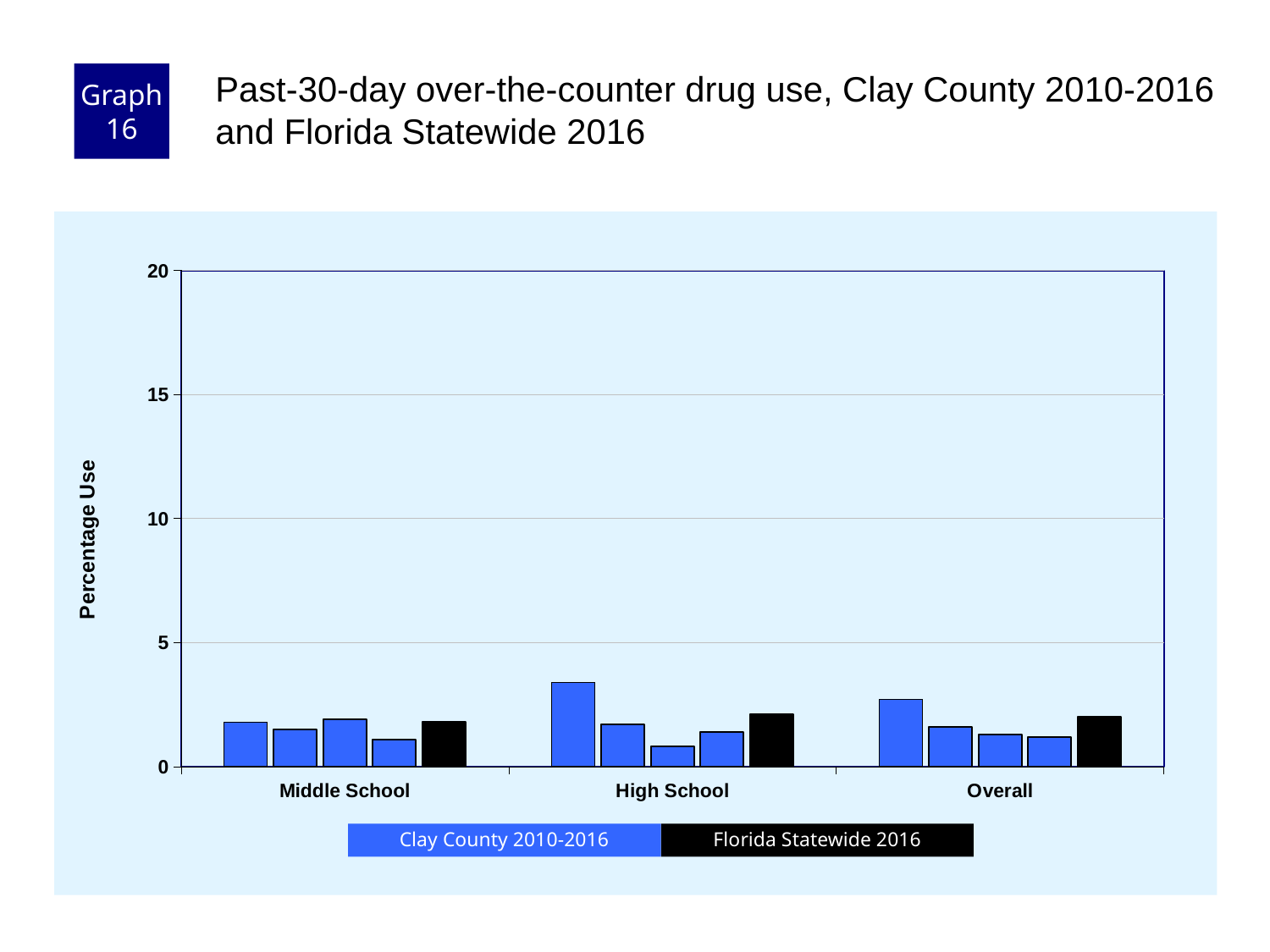
Is the value of the tallest bar in the High School group greater or less than 5? less Which is larger: the first Clay County bar in the High School group or the first Clay County bar in the Middle School group? the first Clay County bar in the High School group How many categories are shown on the x axis? 3 What colour are the Florida Statewide 2016 bars? black How many series does the legend list? 2 What kind of chart is shown on the slide? bar chart Which is larger: the first Clay County bar in the High School group or the Florida Statewide 2016 bar in the High School group? the first Clay County bar in the High School group Is the value of the Florida Statewide 2016 bar for High School greater or less than 5? less What is the label of the y axis? Percentage Use Which is larger: the first Clay County bar in the Overall group or the Florida Statewide 2016 bar in the Overall group? the first Clay County bar in the Overall group Is the value of the Florida Statewide 2016 bar for Middle School greater or less than 5? less Which x-axis category contains the tallest bar on the chart? High School